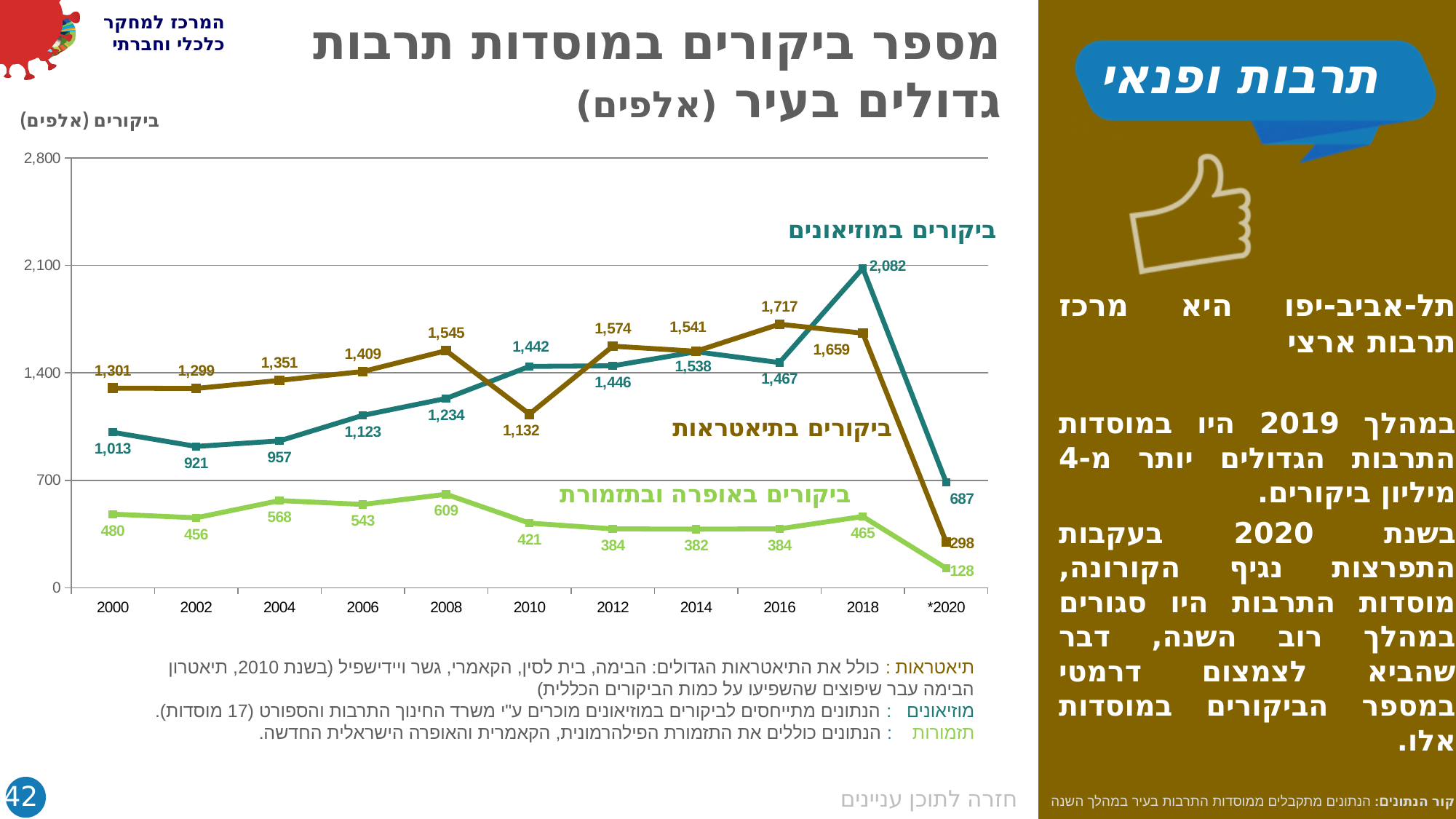
What is the label of the y axis? ביקורים (אלפים) In which year is the museum visits (ביקורים במוזיאונים) line at its highest? 2018 How many years (data points per line) are plotted on the x axis? 11 Is the value for opera and orchestra visits in 2008 greater or less than 700? less In which year is the theater visits (ביקורים בתיאטראות) line at its lowest? *2020 How many series (lines) does the chart show? 3 What kind of chart is shown on the slide? line chart What is the difference between museum visits and theater visits in 2018? 423 Which was larger in 2010: theater visits (ביקורים בתיאטראות) or museum visits (ביקורים במוזיאונים)? museum visits (ביקורים במוזיאונים) What is the value for opera and orchestra visits (ביקורים באופרה ובתזמורת) in *2020? 128 What is the value for museum visits (ביקורים במוזיאונים) in 2018? 2,082 What is the value for theater visits (ביקורים בתיאטראות) in 2016? 1,717